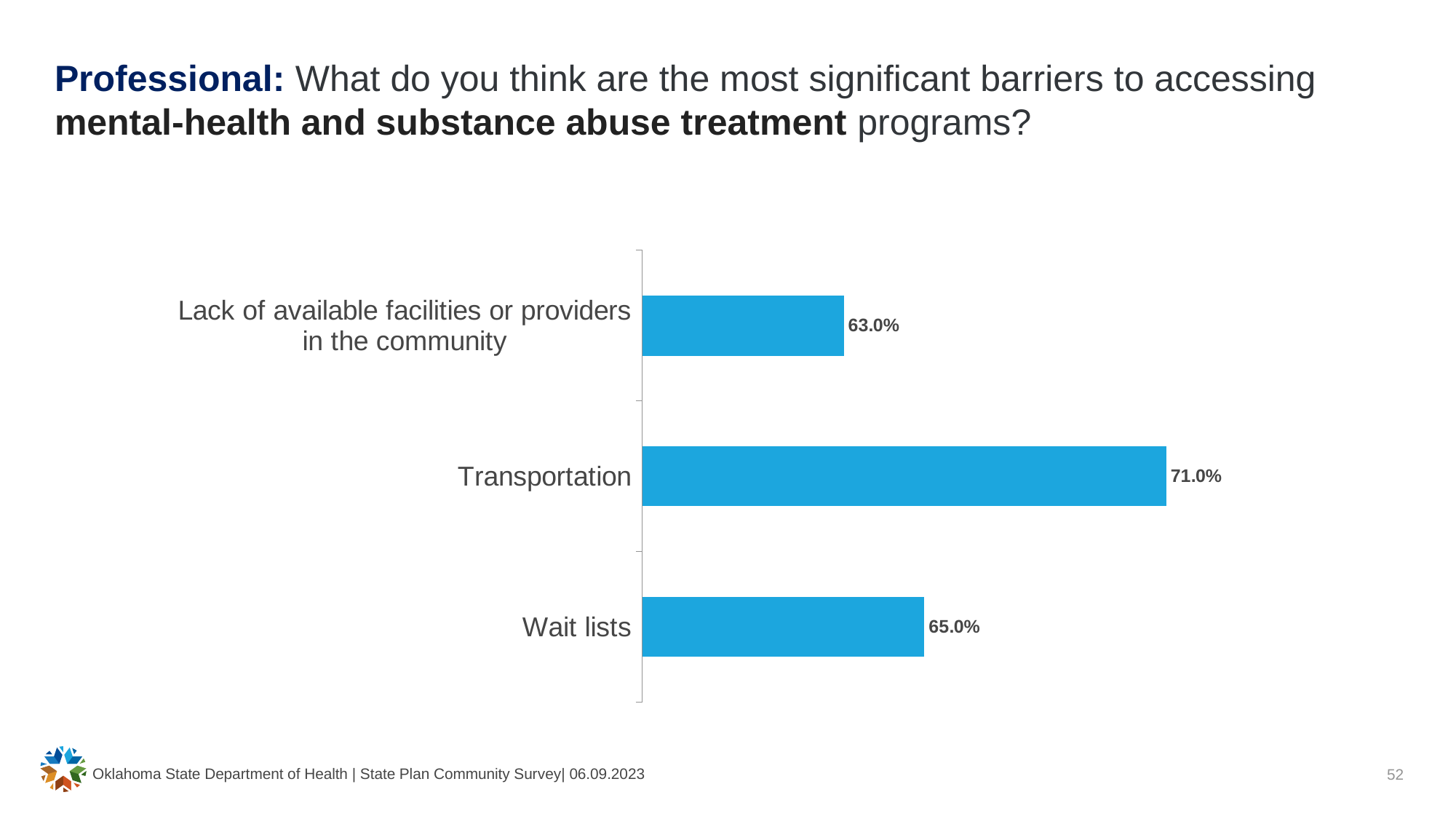
What is the value for Transportation? 71.0% Which is larger, the value for Transportation or the value for Wait lists? Transportation How many categories are shown in the chart? 3 Which category has the lowest value? Lack of available facilities or providers in the community What is the difference between the values for Transportation and Wait lists? 6.0% Which category has the highest value? Transportation Which is larger, the value for Wait lists or the value for Lack of available facilities or providers in the community? Wait lists What is the value for Lack of available facilities or providers in the community? 63.0% What is the difference between the values for Wait lists and Lack of available facilities or providers in the community? 2.0% What is the value for Wait lists? 65.0% What colour are the bars in the chart? Blue What kind of chart is shown on the slide? Bar chart